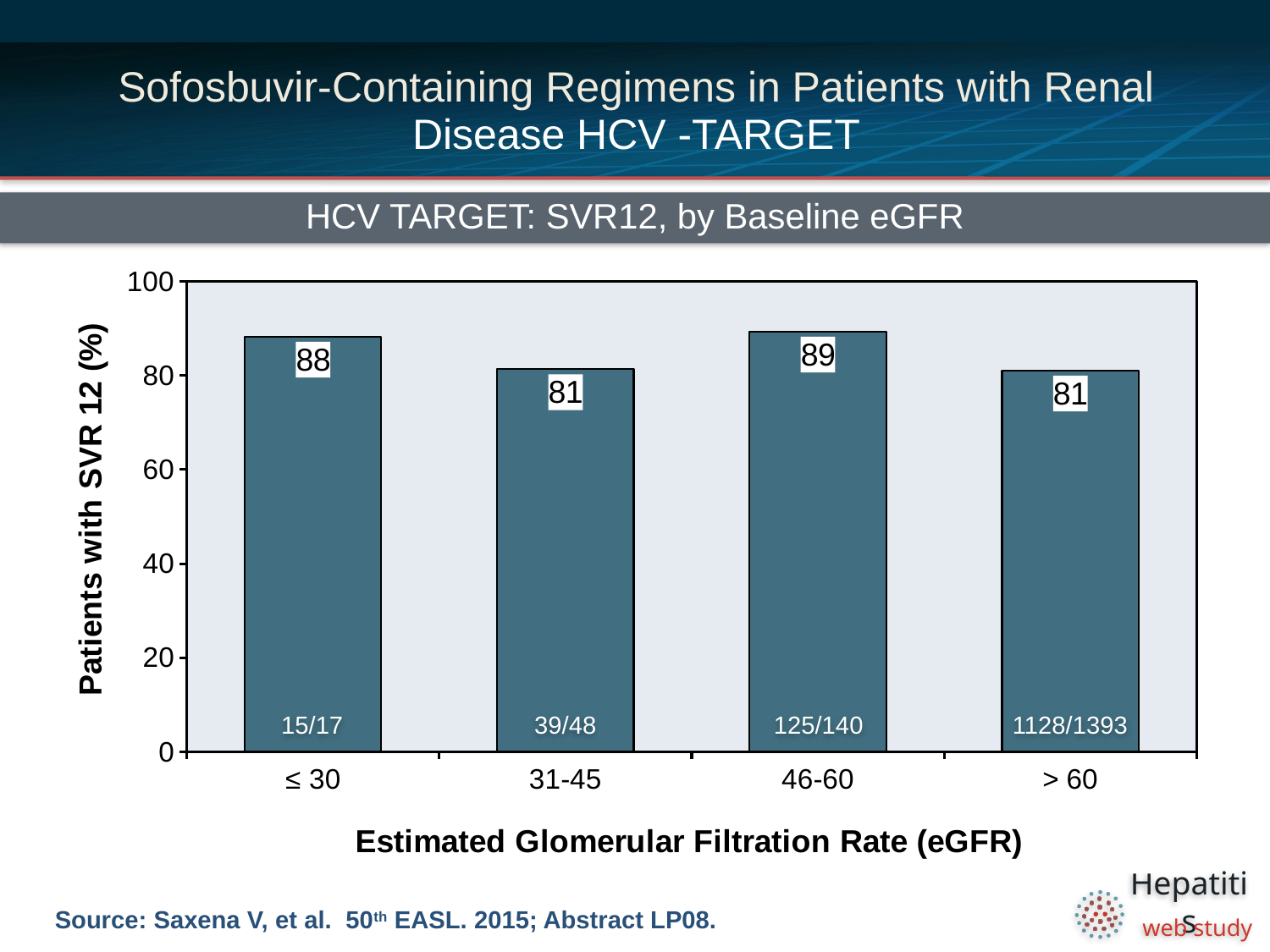
What fraction is printed on the bar for the eGFR > 60 group? 1128/1393 How many patients achieved SVR12 out of the total in the eGFR 31-45 group, as printed on the bar? 39/48 Which has a higher SVR12 rate: the eGFR ≤ 30 group or the eGFR > 60 group? ≤ 30 What is the SVR12 rate for patients with eGFR ≤ 30? 88 Which eGFR group has the highest SVR12 rate? 46-60 What is the difference in SVR12 rate between the eGFR 46-60 group and the eGFR 31-45 group? 8 What kind of chart is shown on the slide? Bar chart How many eGFR categories are shown on the x axis? 4 What is the label of the y axis? Patients with SVR 12 (%) What is the SVR12 rate for patients with eGFR 46-60? 89 Is the SVR12 rate for the eGFR 31-45 group greater or less than 60? greater What is the SVR12 rate for patients with eGFR > 60? 81